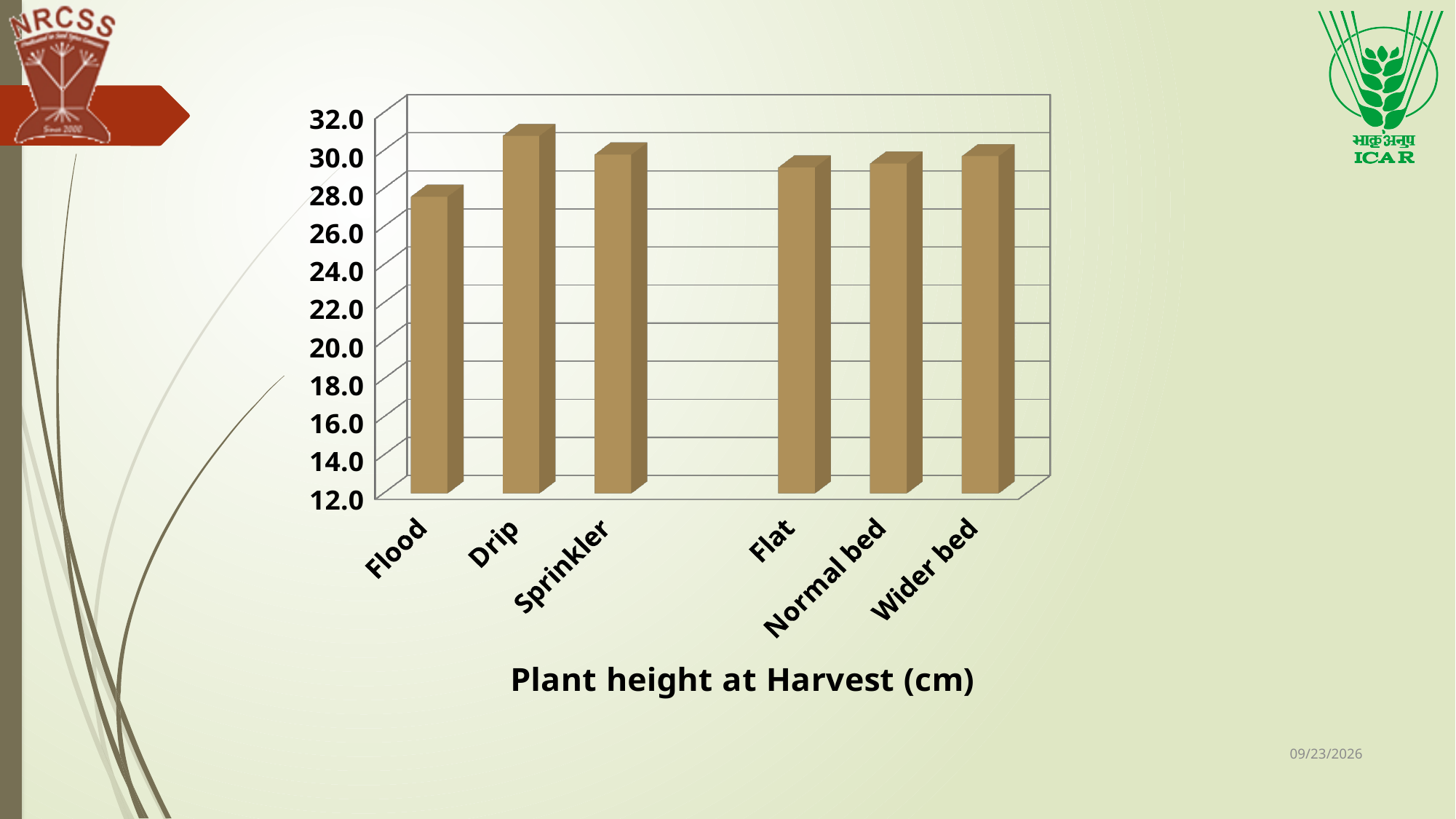
How many categories are plotted on the x axis? 6 Which category has the lowest plant height at harvest? Flood Is the value for Drip greater or less than 30.0? greater Is the value for Flood greater or less than 30.0? less Is the value for Flood greater or less than 26.0? greater What kind of chart is shown on the slide? bar chart Which category has the highest plant height at harvest? Drip Which is larger, the value for Drip or the value for Flood? Drip Which is larger, the value for Flood or the value for Sprinkler? Sprinkler Which is larger, the value for Drip or the value for Flat? Drip What is the title of the chart? Plant height at Harvest (cm)